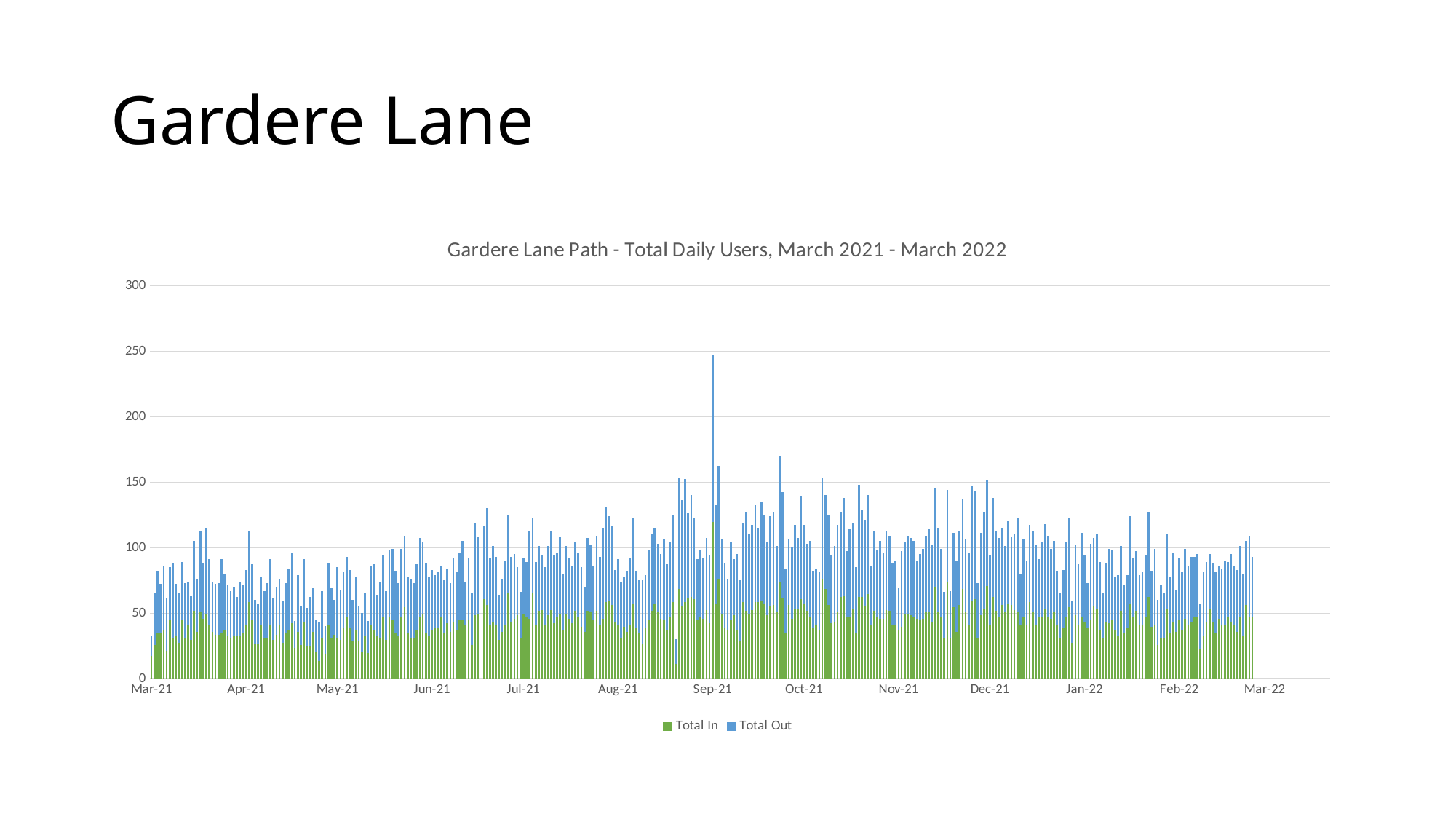
Is the tallest stacked bar greater or less than 300? less Is the tallest stacked bar on the chart greater or less than 200? greater Are the bars in the chart stacked or placed side by side? Stacked What is the highest value shown on the vertical axis? 300 How many month labels are shown along the x axis? 13 What are the two series named in the legend? Total In and Total Out How many series does the chart legend list? 2 Which series generally contributes the larger portion of each stacked bar, Total In or Total Out? Total Out Near which x-axis label does the tallest stacked bar appear? Sep-21 What kind of chart is shown on the slide? Bar chart